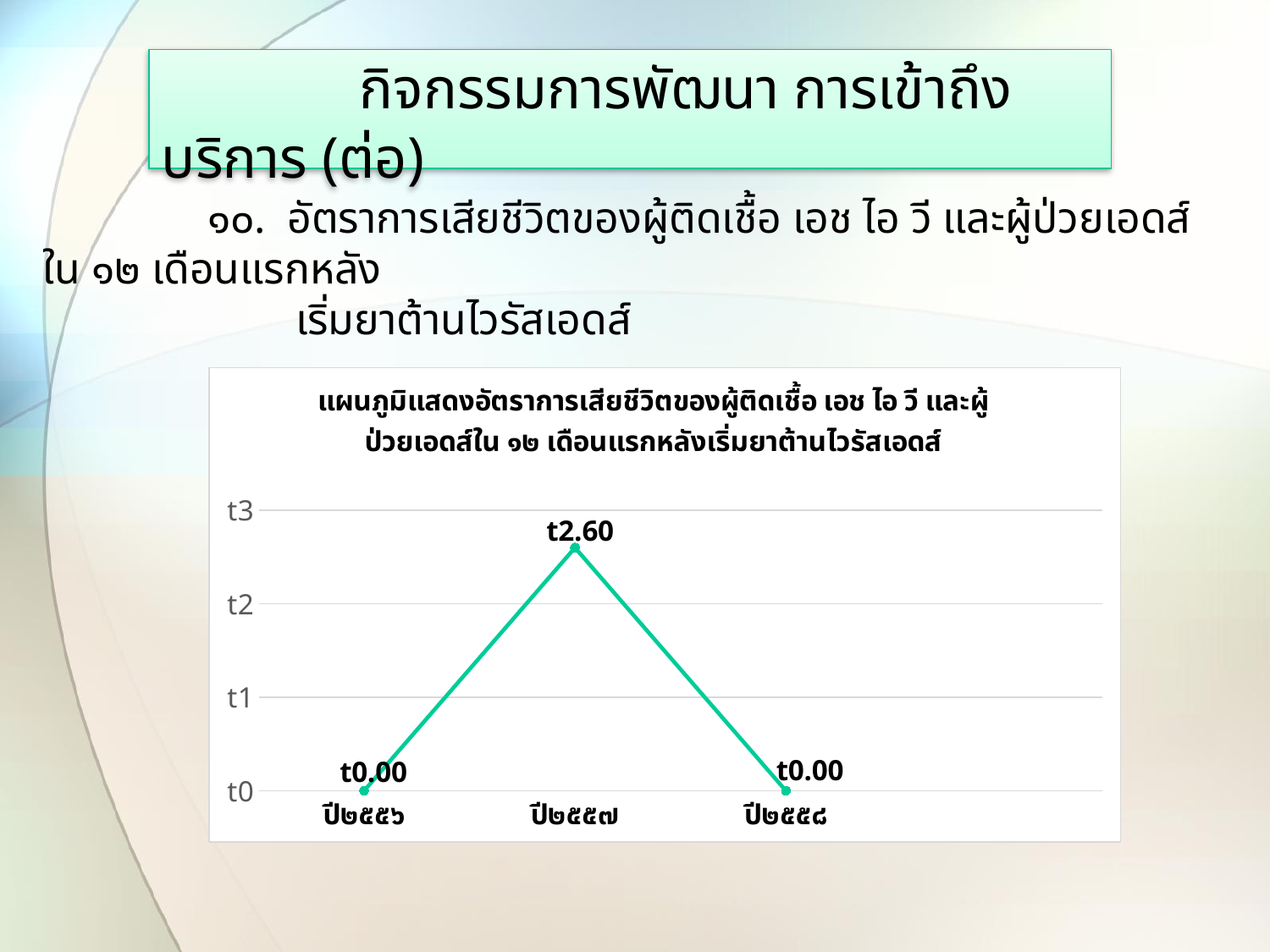
Which category has the highest value? ปี๒๕๕๗ What is the highest tick label shown on the vertical axis? t3 What is the value plotted for ปี๒๕๕๗? t2.60 What is the value plotted for ปี๒๕๕๘? t0.00 Does the value rise or fall from ปี๒๕๕๗ to ปี๒๕๕๘? fall How many data points are plotted on the line? 3 What type of chart is shown on the slide? line chart What is the value plotted for ปี๒๕๕๖? t0.00 Which is larger, the value for ปี๒๕๕๗ or the value for ปี๒๕๕๘? ปี๒๕๕๗ What is the label of the first category on the x axis? ปี๒๕๕๖ What is the difference between the values for ปี๒๕๕๗ and ปี๒๕๕๖? t2.60 Is the value for ปี๒๕๕๗ greater or less than t2? greater